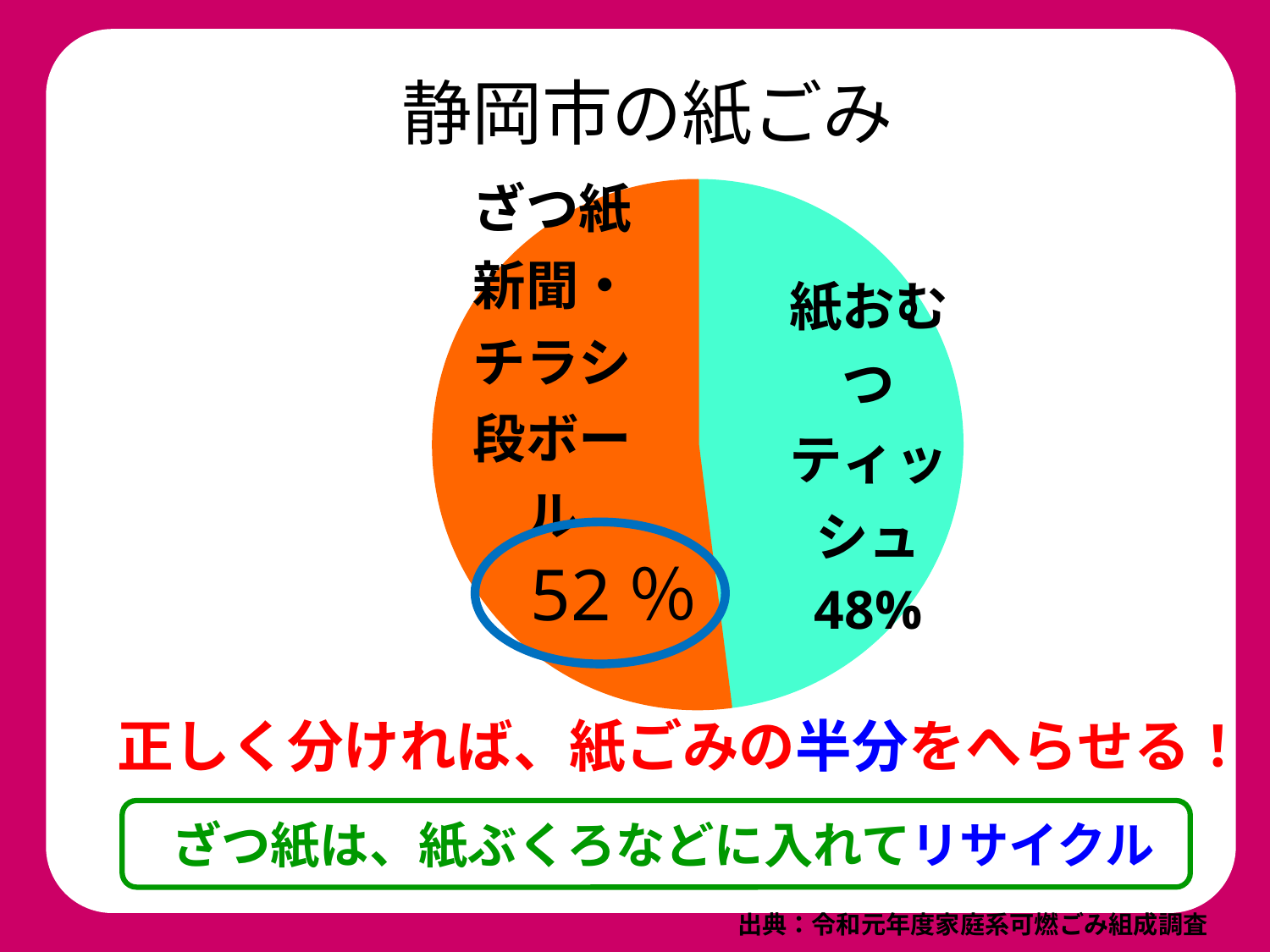
What is the title of the chart? 静岡市の紙ごみ Which slice of the pie is the smallest? 紙おむつ・ティッシュ What share of the pie is labelled ざつ紙 (新聞・チラシ・段ボール)? 52 % Is the share for 紙おむつ・ティッシュ greater or less than 50%? less What share of the pie is labelled 紙おむつ・ティッシュ? 48% Which slice of the pie is the largest? ざつ紙 (新聞・チラシ・段ボール) What is the total of the two slices shown in the pie chart? 100% What kind of chart is shown on the slide? pie chart What colour is the ざつ紙 slice of the pie? orange Which is larger, the ざつ紙 slice or the 紙おむつ・ティッシュ slice? ざつ紙 What is the difference in percentage points between the ざつ紙 slice and the 紙おむつ・ティッシュ slice? 4 percentage points How many slices does the pie chart have? 2